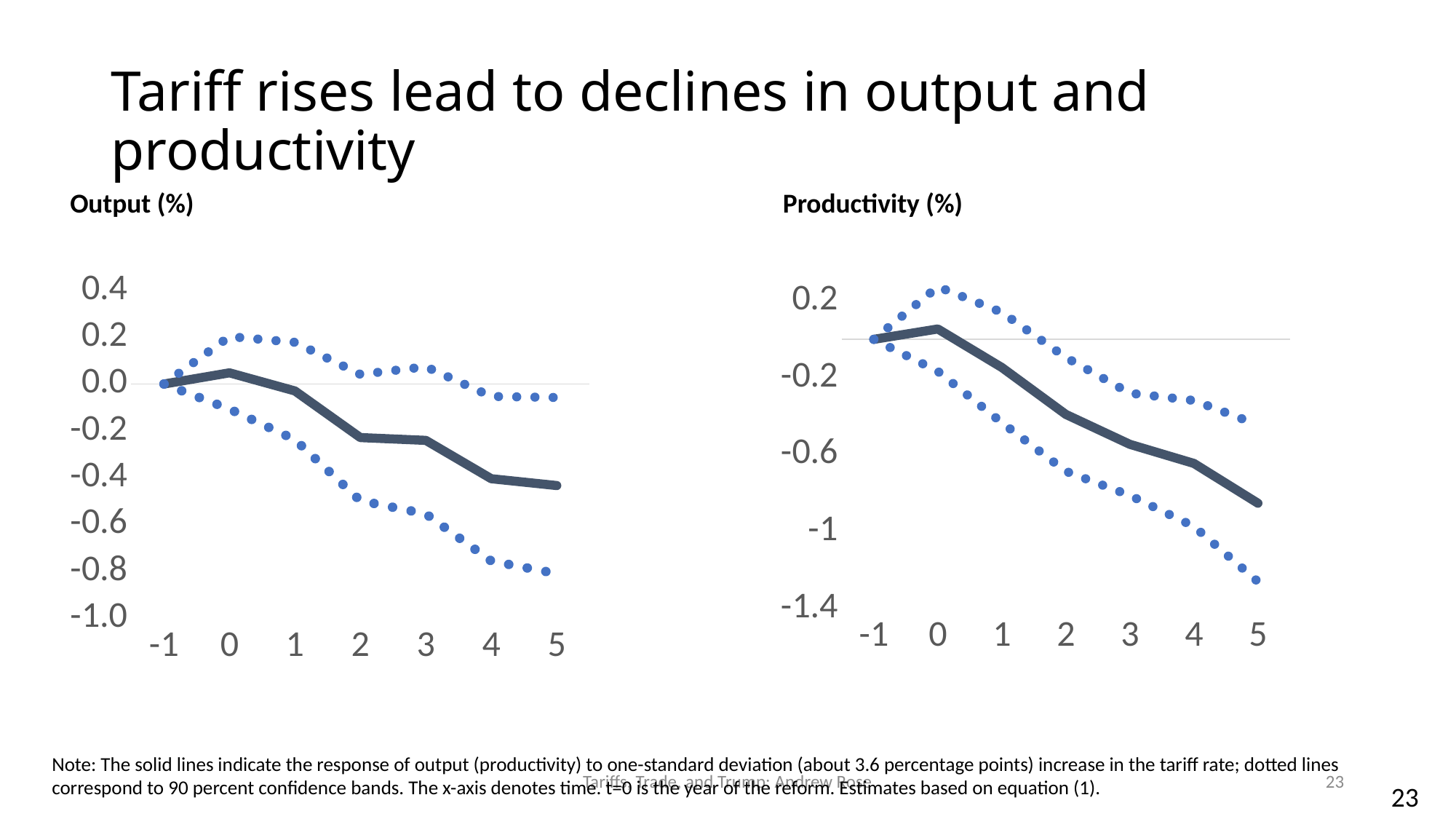
In the Output (%) chart, does the solid line rise or fall from t=0 to t=5? fall How many time points are shown on the x axis of the Productivity (%) chart? 7 In the Productivity (%) chart, at which time point does the solid line reach its lowest value? 5 In the Productivity (%) chart, is the solid line value at t=5 greater or less than -0.6? less In the Productivity (%) chart, does the solid line rise or fall from t=0 to t=5? fall What is the title of the chart on the right side of the slide? Productivity (%) In the Productivity (%) chart, is the lower dotted line value at t=5 greater or less than -1? less In the Output (%) chart, at which time point does the solid line reach its highest value? 0 In the Output (%) chart, is the solid line value higher at t=1 or at t=3? t=1 In the Output (%) chart, is the solid line value at t=5 greater or less than -0.2? less What kind of chart is the Output (%) chart? line chart In the Productivity (%) chart, at which time point does the solid line reach its highest value? 0